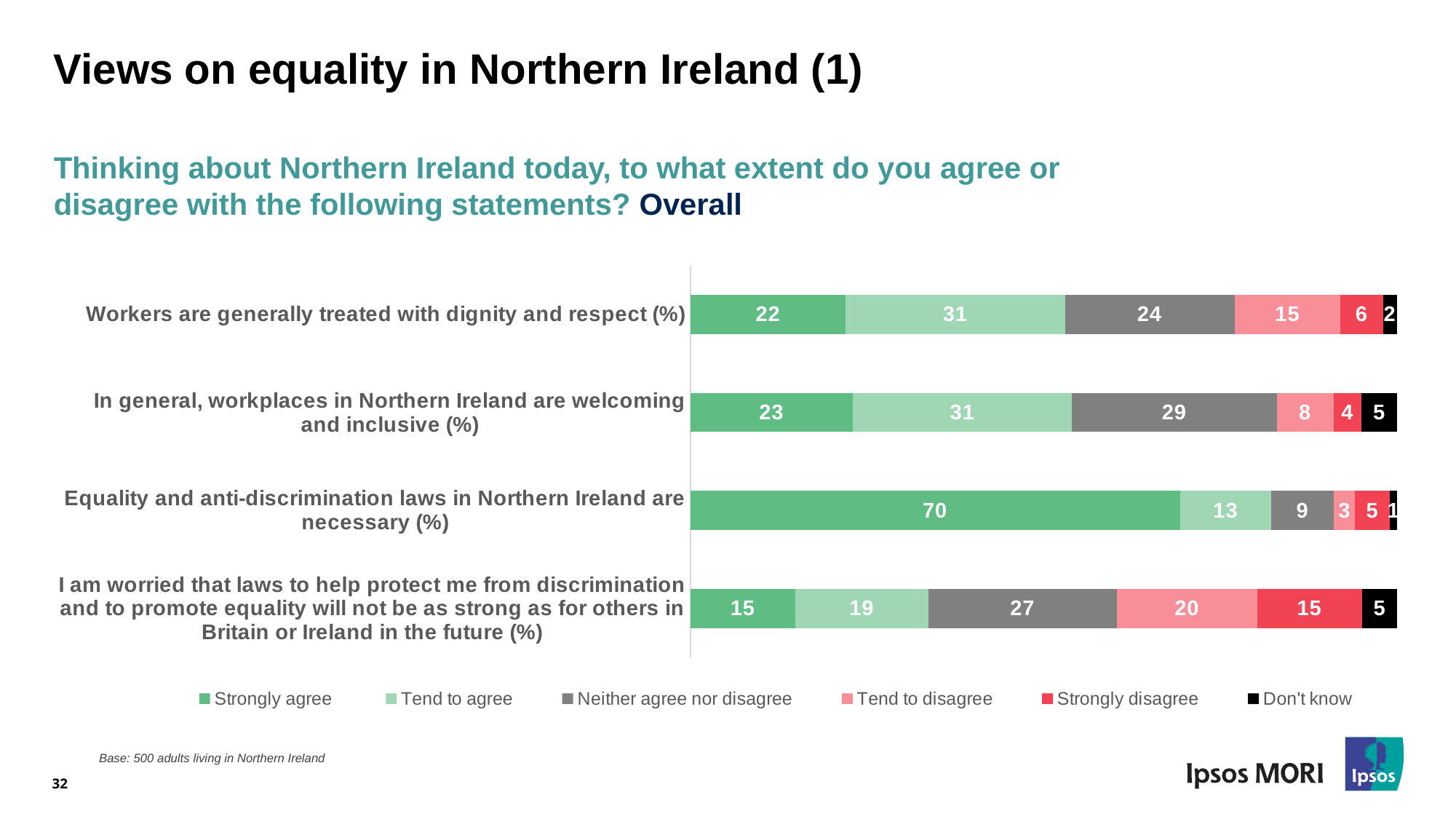
What is the 'Neither agree nor disagree' value for 'In general, workplaces in Northern Ireland are welcoming and inclusive'? 29 What is the total of the stacked bar for 'Workers are generally treated with dignity and respect'? 100 What is the 'Strongly disagree' value for the statement about being worried that laws to protect from discrimination will not be as strong as for others in Britain or Ireland? 15 What is the 'Don't know' value for 'Workers are generally treated with dignity and respect'? 2 How many statements are shown in the chart? 4 Which statement has the lowest 'Tend to agree' value? Equality and anti-discrimination laws in Northern Ireland are necessary How many series does the legend list? 6 What is the difference between the 'Tend to disagree' values for 'Workers are generally treated with dignity and respect' and 'In general, workplaces in Northern Ireland are welcoming and inclusive'? 7 What kind of chart is shown on the slide? Stacked horizontal bar chart Which statement has the highest 'Strongly agree' value? Equality and anti-discrimination laws in Northern Ireland are necessary What percentage strongly agree that equality and anti-discrimination laws in Northern Ireland are necessary? 70 Which is larger: the 'Neither agree nor disagree' value for 'Workers are generally treated with dignity and respect' or for the statement about being worried that laws will not be as strong as for others? The statement about being worried that laws will not be as strong as for others (27)